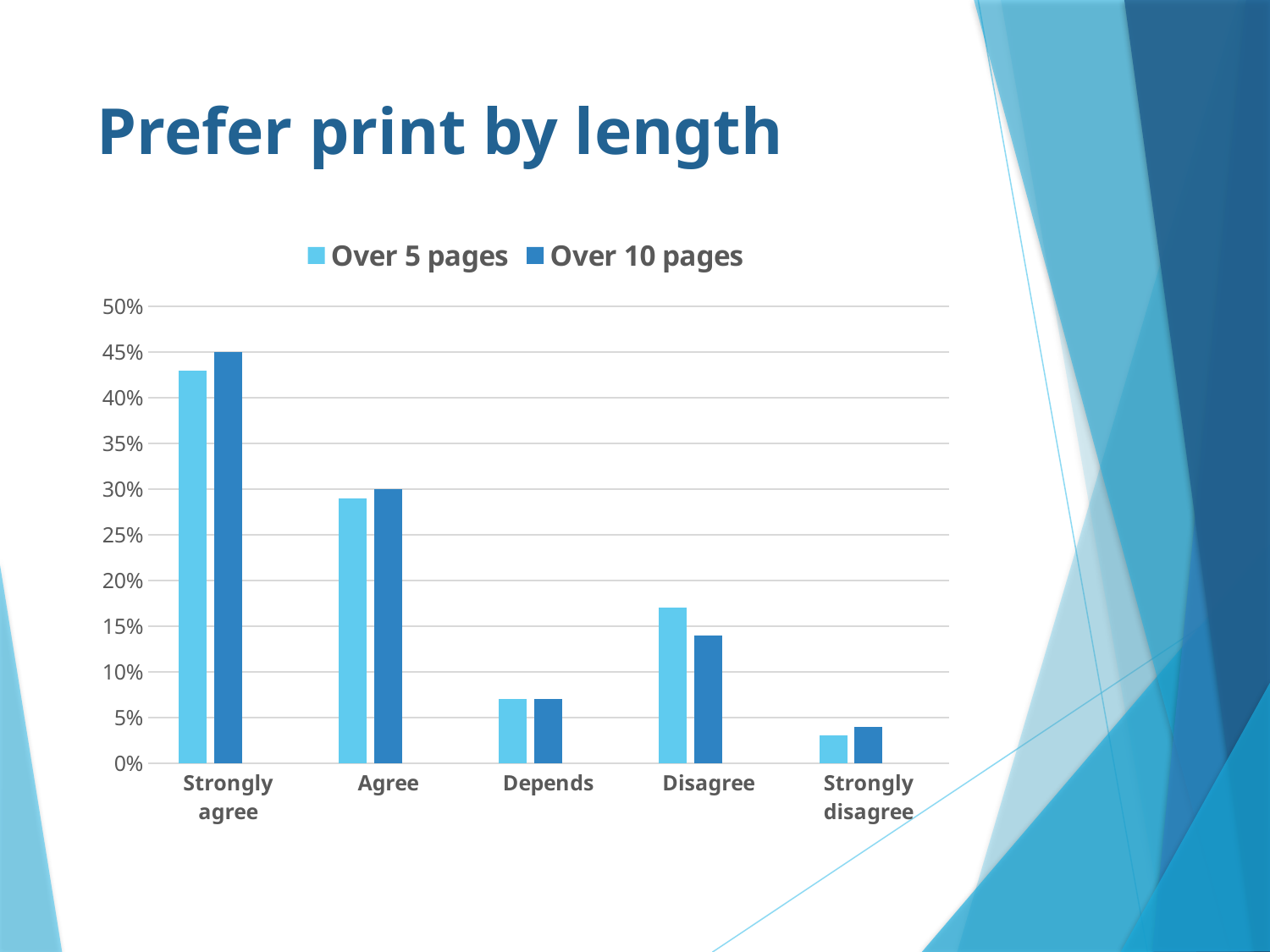
Which series is shown in the darker blue colour? Over 10 pages In the Disagree category, which series has the larger value, Over 5 pages or Over 10 pages? Over 5 pages Which category has the highest value for Over 5 pages? Strongly agree How many series does the legend list? 2 Is the value for Over 5 pages in the Strongly agree category greater or less than 40%? greater How many categories are shown on the x axis? 5 Do the values for Over 5 pages generally rise or fall from Strongly agree to Strongly disagree? fall What type of chart is shown on the slide? bar chart Which category has the lowest value for Over 10 pages? Strongly disagree Is the value for Over 5 pages in the Depends category greater or less than 10%? less What is the title of the chart on the slide? Prefer print by length